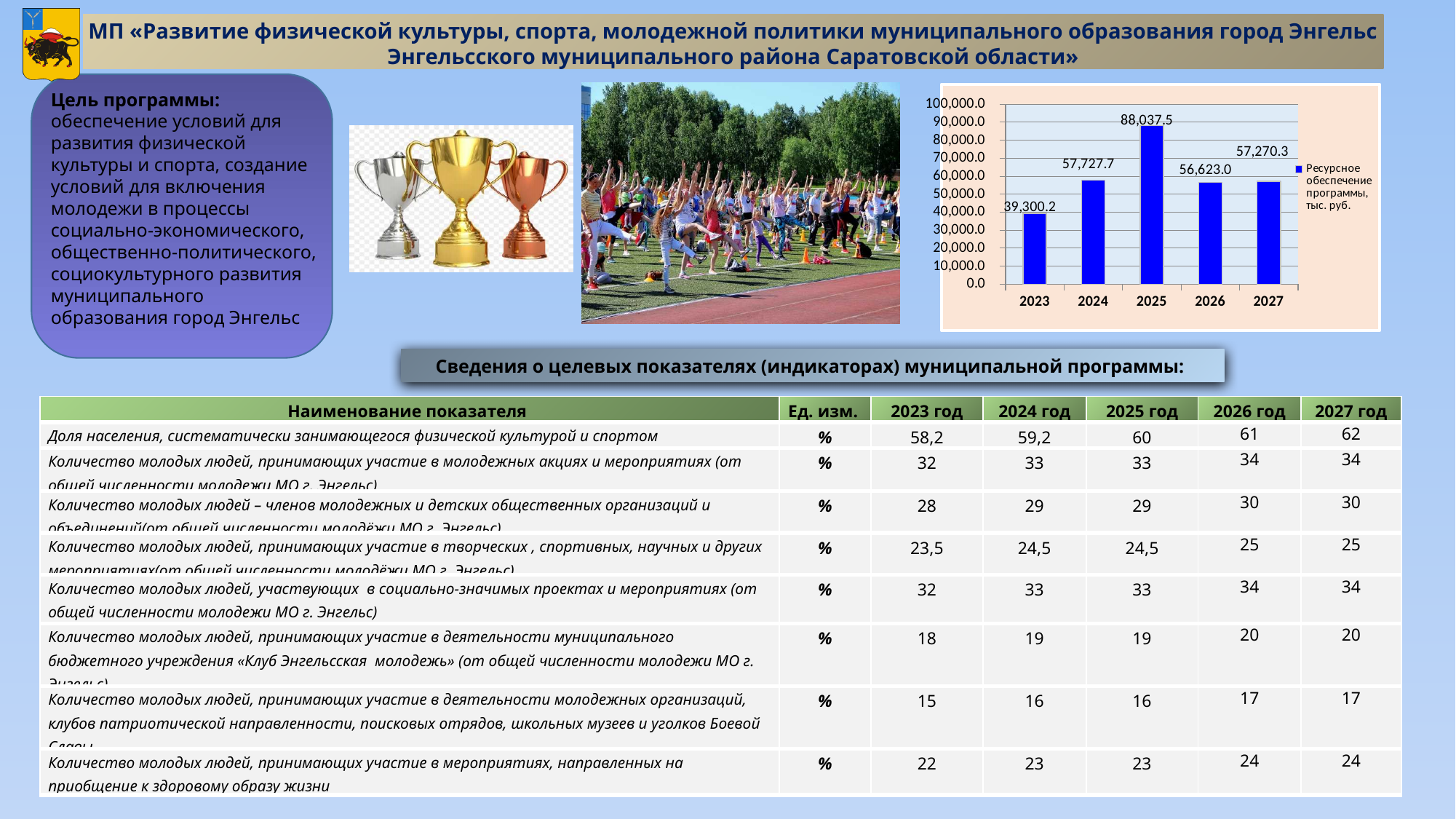
Which year has the highest value in the bar chart? 2025 How many years are shown on the x axis of the bar chart? 5 What is the value for 2027 in the bar chart? 57,270.3 What kind of chart is shown on the slide? bar chart What is the difference between the values for 2025 and 2023 in the bar chart? 48,737.3 What is the difference between the values for 2027 and 2026 in the bar chart? 647.3 What is the value for 2023 in the bar chart? 39,300.2 Which year has the lowest value in the bar chart? 2023 Which is larger in the bar chart, the value for 2024 or the value for 2023? 2024 What is the value for 2025 in the bar chart? 88,037.5 Is the value for 2025 in the bar chart greater or less than 80,000.0? greater What is the value for 2026 in the bar chart? 56,623.0